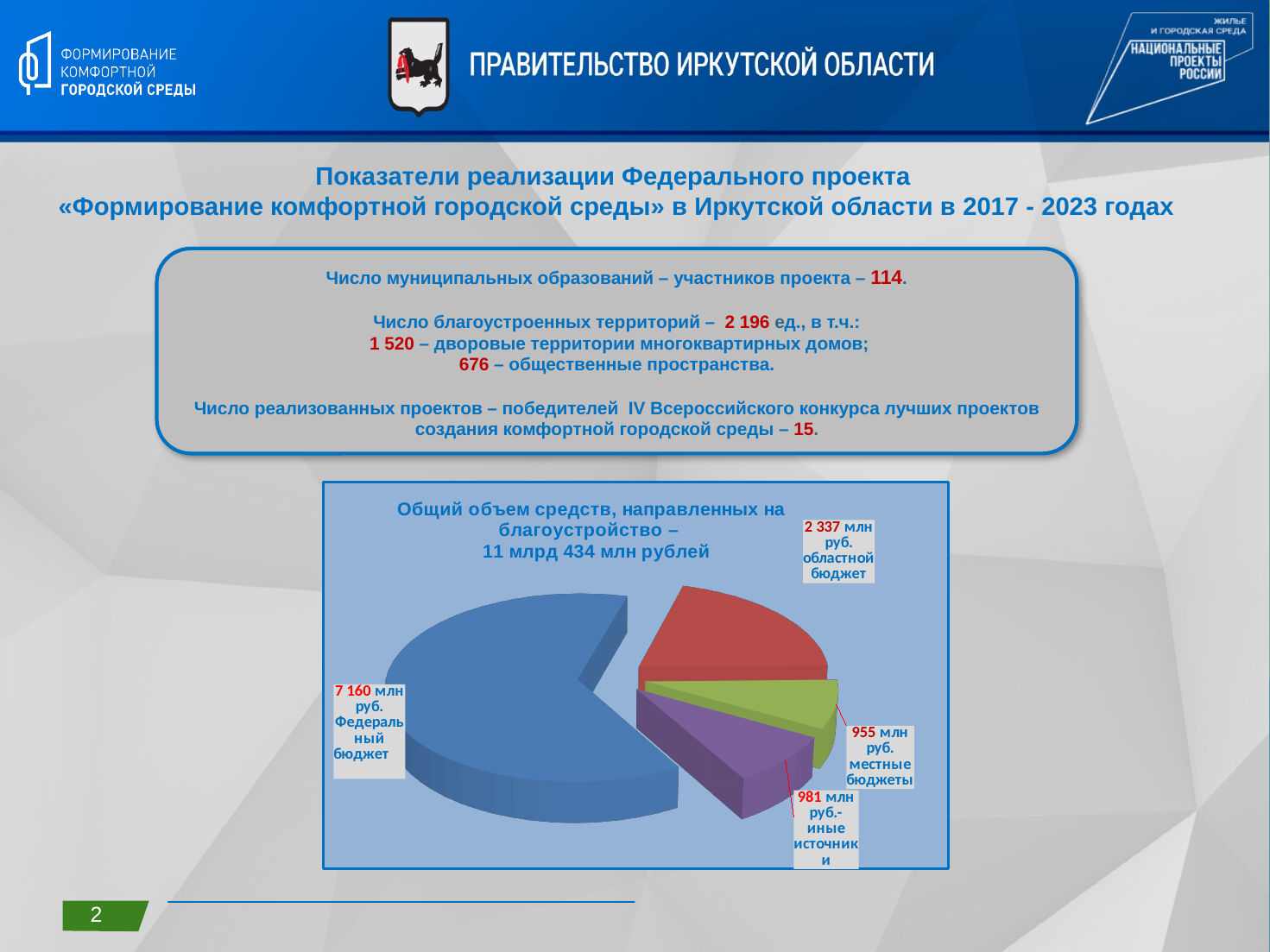
What is the value for the местные бюджеты slice? 955 млн руб. How many slices does the pie chart have? 4 What is the value for the областной бюджет slice? 2 337 млн руб. Which source accounts for the smallest slice of the pie chart? местные бюджеты What total amount of funds does the chart title state was directed to благоустройство? 11 млрд 434 млн рублей What is the difference between the Федеральный бюджет and областной бюджет values? 4 823 млн руб. What colour is the Федеральный бюджет slice? Blue What is the value for the Федеральный бюджет slice? 7 160 млн руб. What type of chart is shown on the slide? Pie chart What is the value for the иные источники slice? 981 млн руб. Which is larger: иные источники or местные бюджеты? иные источники Which source accounts for the largest slice of the pie chart? Федеральный бюджет